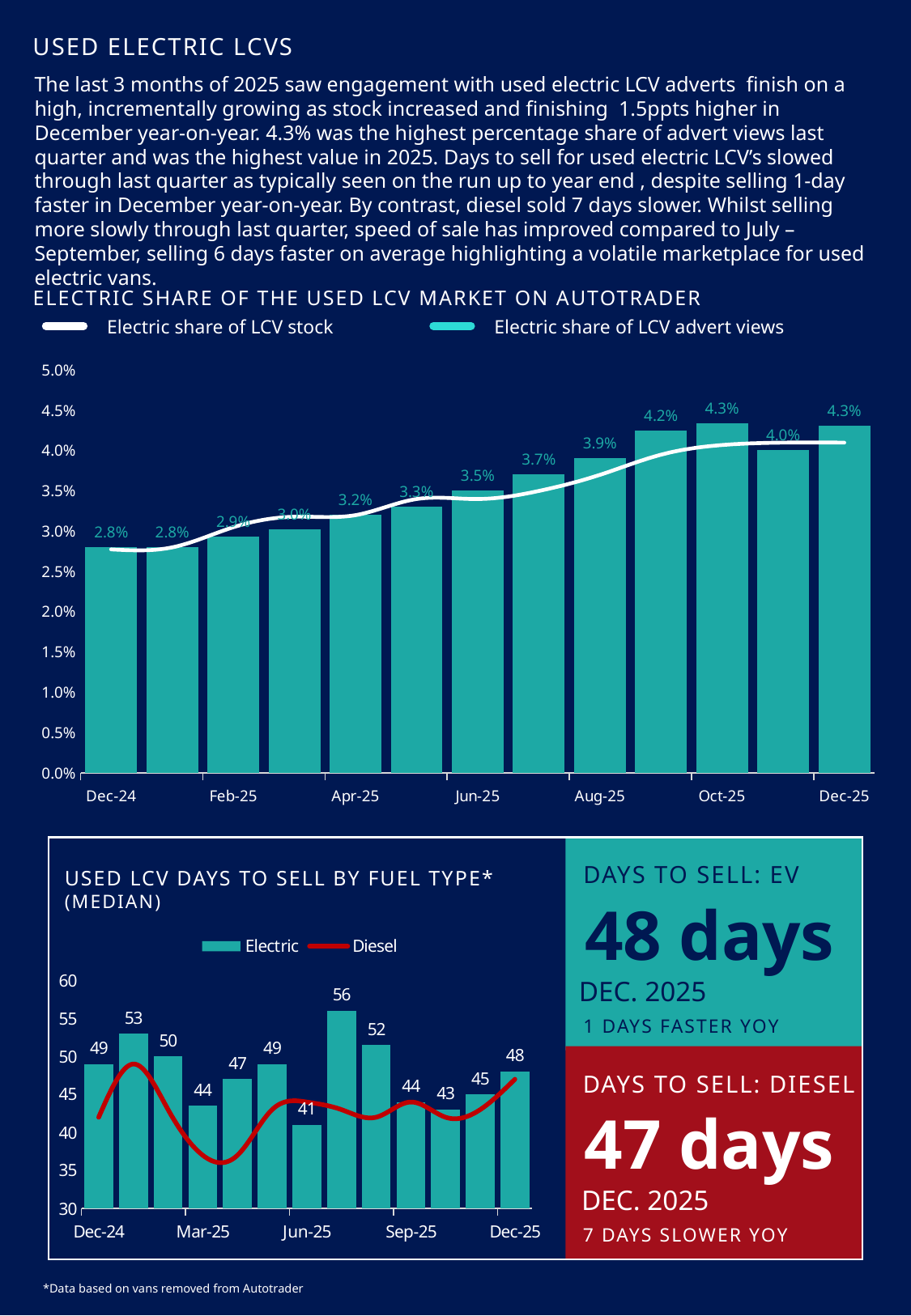
In the 'Electric share of the used LCV market on Autotrader' chart, does the electric share of LCV advert views generally rise or fall from Dec-24 to Dec-25? Rise What kind of chart is the 'Electric share of the used LCV market on Autotrader' chart? A bar chart with a line overlay In the 'Used LCV days to sell by fuel type (median)' chart, which month has the highest Electric days to sell? Jul-25 (56) How many Electric bars are plotted in the 'Used LCV days to sell by fuel type (median)' chart? 13 In the 'Electric share of the used LCV market on Autotrader' chart, by how many percentage points did the electric share of LCV advert views rise from Dec-24 to Dec-25? 1.5 percentage points In the 'Electric share of the used LCV market on Autotrader' chart, is the electric share of LCV stock in Dec-24 greater or less than 3.0%? less In the 'Electric share of the used LCV market on Autotrader' chart, what is the electric share of LCV advert views for Dec-24? 2.8% In the 'Used LCV days to sell by fuel type (median)' chart, which month has the lowest Electric days to sell? Jun-25 (41) In the 'Electric share of the used LCV market on Autotrader' chart, what is the electric share of LCV advert views for Dec-25? 4.3% In the 'Used LCV days to sell by fuel type (median)' chart, what is the Electric value for Dec-25? 48 How many series does the legend of the 'Electric share of the used LCV market on Autotrader' chart list? 2 In the 'Used LCV days to sell by fuel type (median)' chart, what is the difference between the highest Electric value (56) and the lowest Electric value (41)? 15